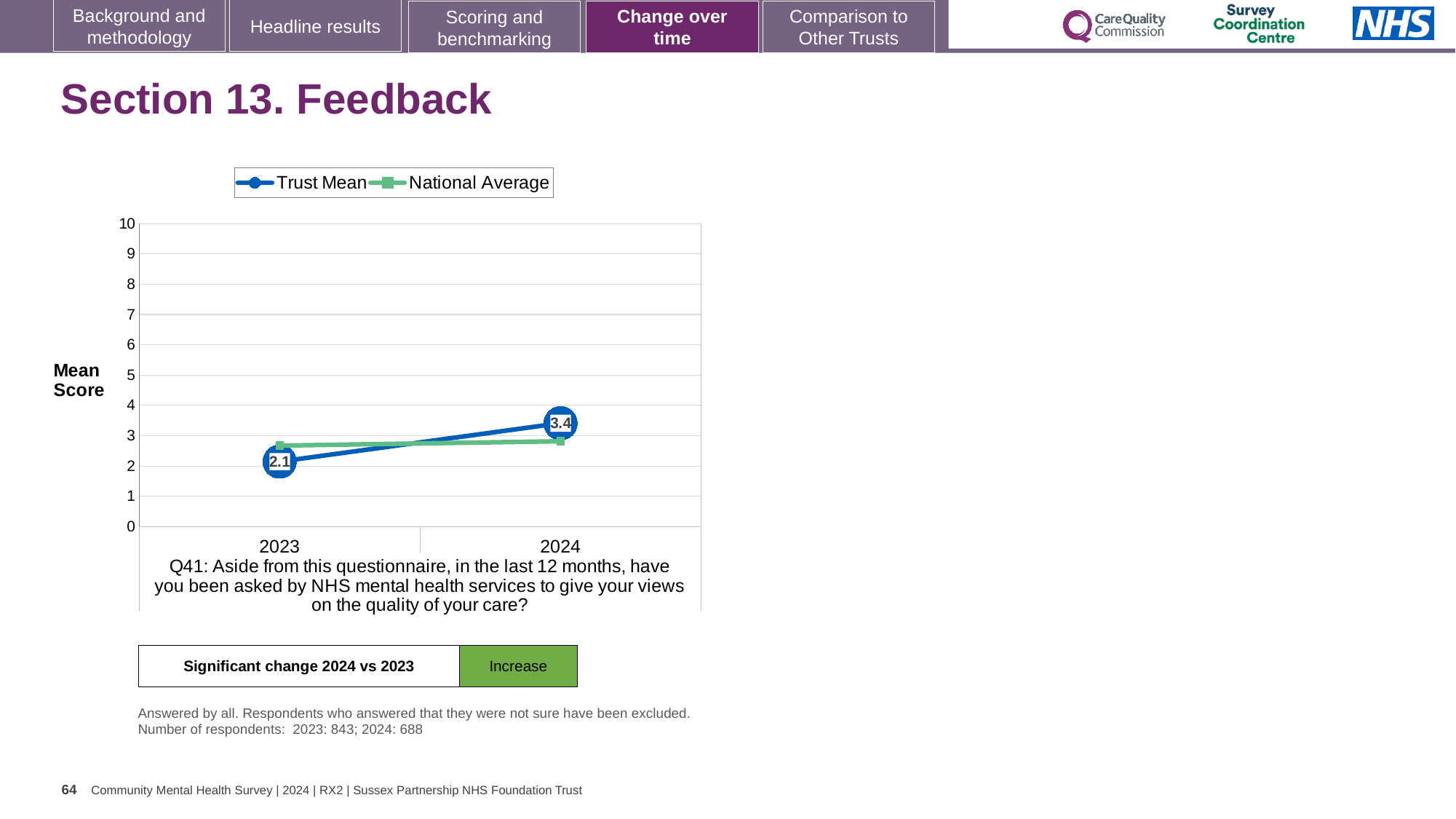
What is the label on the vertical axis of the chart? Mean Score By how much did the Trust Mean score change from 2023 to 2024? 1.3 Is the National Average value for 2023 greater or less than 3? less How many series does the legend list? 2 In 2023, which is higher: the Trust Mean or the National Average? National Average In which year is the Trust Mean score higher? 2024 What kind of chart is shown on the slide? line chart In 2024, which is higher: the Trust Mean or the National Average? Trust Mean What is the Trust Mean score for 2024? 3.4 Is the National Average value for 2023 greater or less than 2? greater Does the Trust Mean rise or fall from 2023 to 2024? rise What is the Trust Mean score for 2023? 2.1